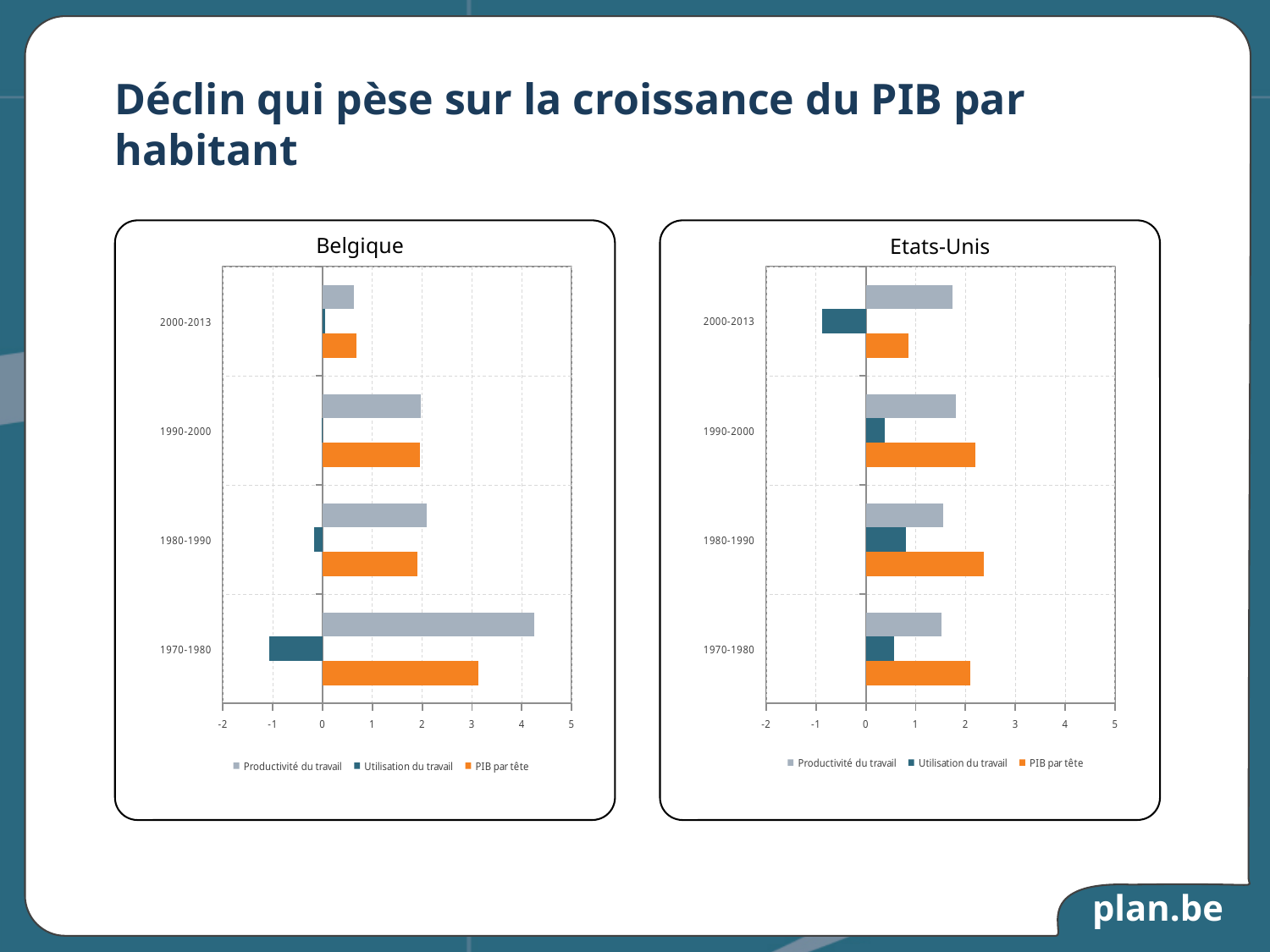
Which chart shows the larger Productivité du travail value for 1970-1980, Belgique or Etats-Unis? Belgique In the Belgique chart, is the value of Productivité du travail for 1970-1980 greater or less than 4? greater In the Belgique chart, in which period is Productivité du travail highest? 1970-1980 What type of chart is used for Belgique? bar chart In the Etats-Unis chart, is the value of Productivité du travail for 2000-2013 greater or less than 1? greater In the Etats-Unis chart, in which period is Utilisation du travail lowest? 2000-2013 In the Belgique chart, in which period is PIB par tête highest? 1970-1980 In the Etats-Unis chart, is the value of PIB par tête for 1980-1990 greater or less than 2? greater How many series does the legend of the Etats-Unis chart list? 3 In the Belgique chart, does Productivité du travail rise or fall overall from 1970-1980 to 2000-2013? fall How many periods are shown on the Belgique chart? 4